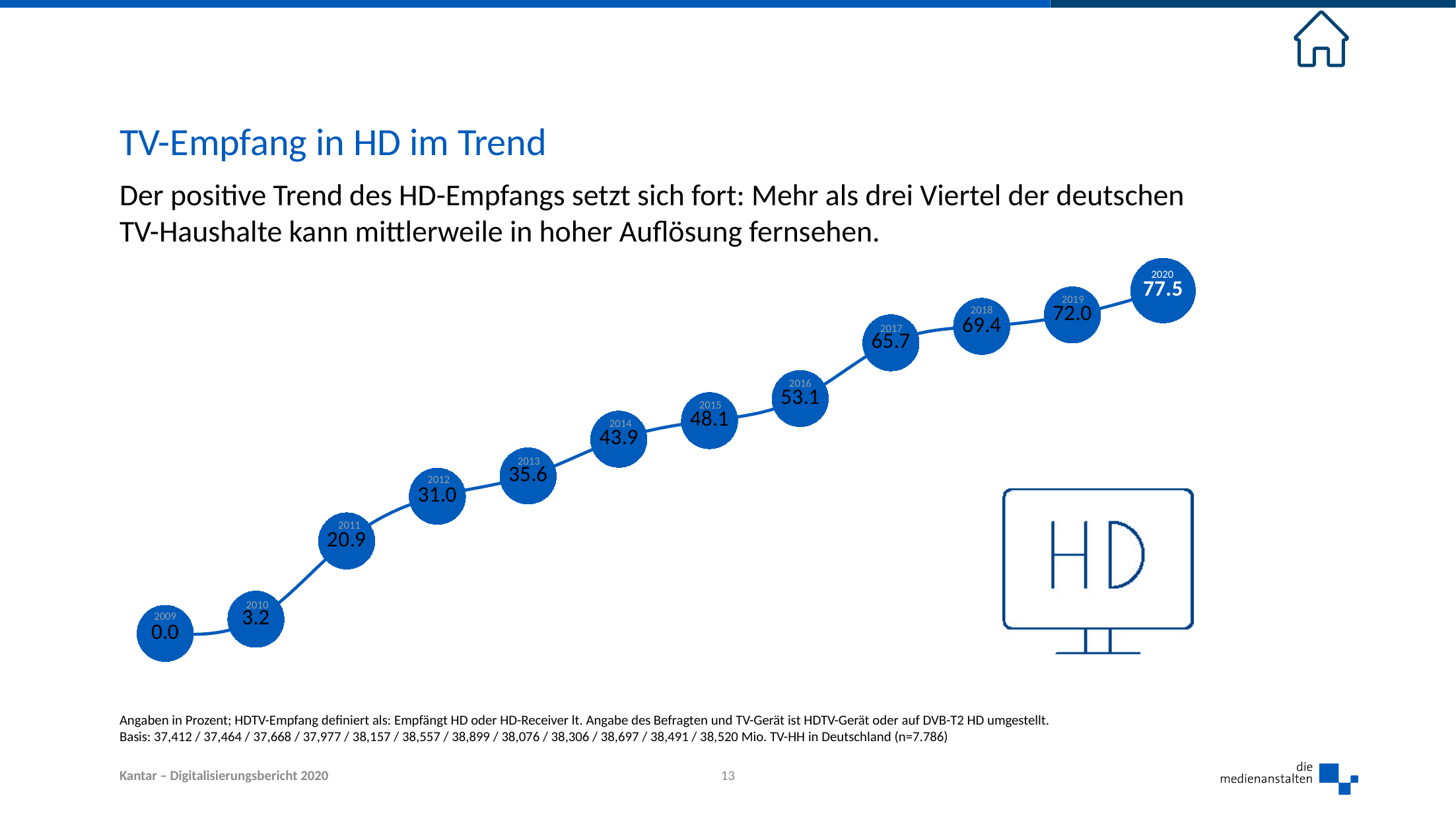
What is the title of the slide containing the chart? TV-Empfang in HD im Trend Which year has the highest value? 2020 What is the value for 2014? 43.9 What is the difference between the values for 2017 and 2016? 12.6 Do the values rise or fall from 2009 to 2020? rise Which is larger, the value for 2015 or the value for 2013? 2015 What is the difference between the values for 2020 and 2019? 5.5 What is the value for 2011? 20.9 What kind of chart is shown on the slide? line chart Which year has the lowest value? 2009 What is the value for 2020? 77.5 How many years are plotted on the chart? 12